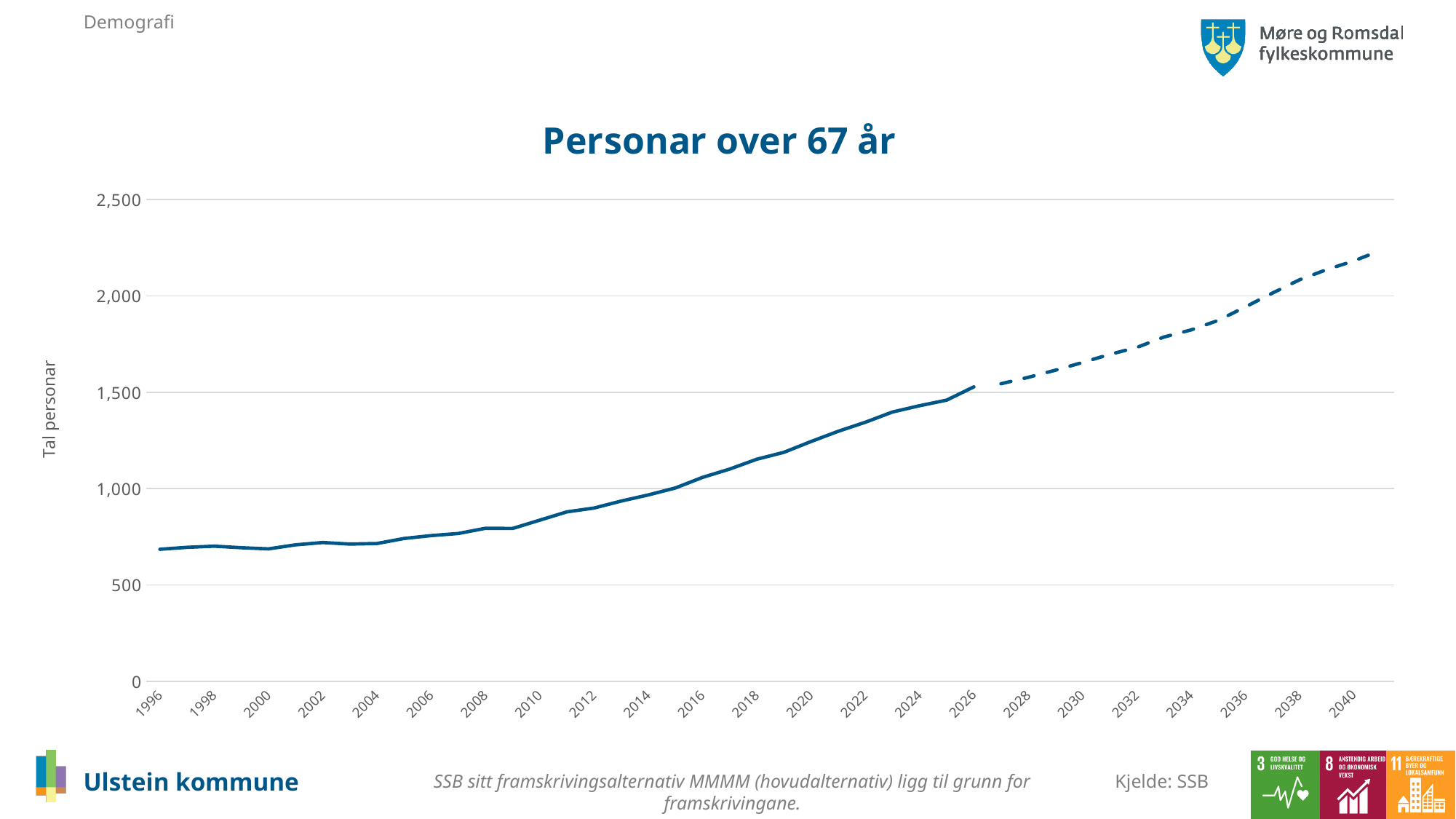
What kind of chart is shown on the slide? line chart What is the label on the vertical axis of the chart? Tal personar Is the value for 2030 greater or less than 1,500? greater Is the value for 2024 greater or less than 1,500? less Do the values rise or fall along the x axis from 1996 to 2040? rise Is the value for 1996 greater or less than 1,000? less Which year has the larger value, 2000 or 2020? 2020 What is the title of the chart? Personar over 67 år